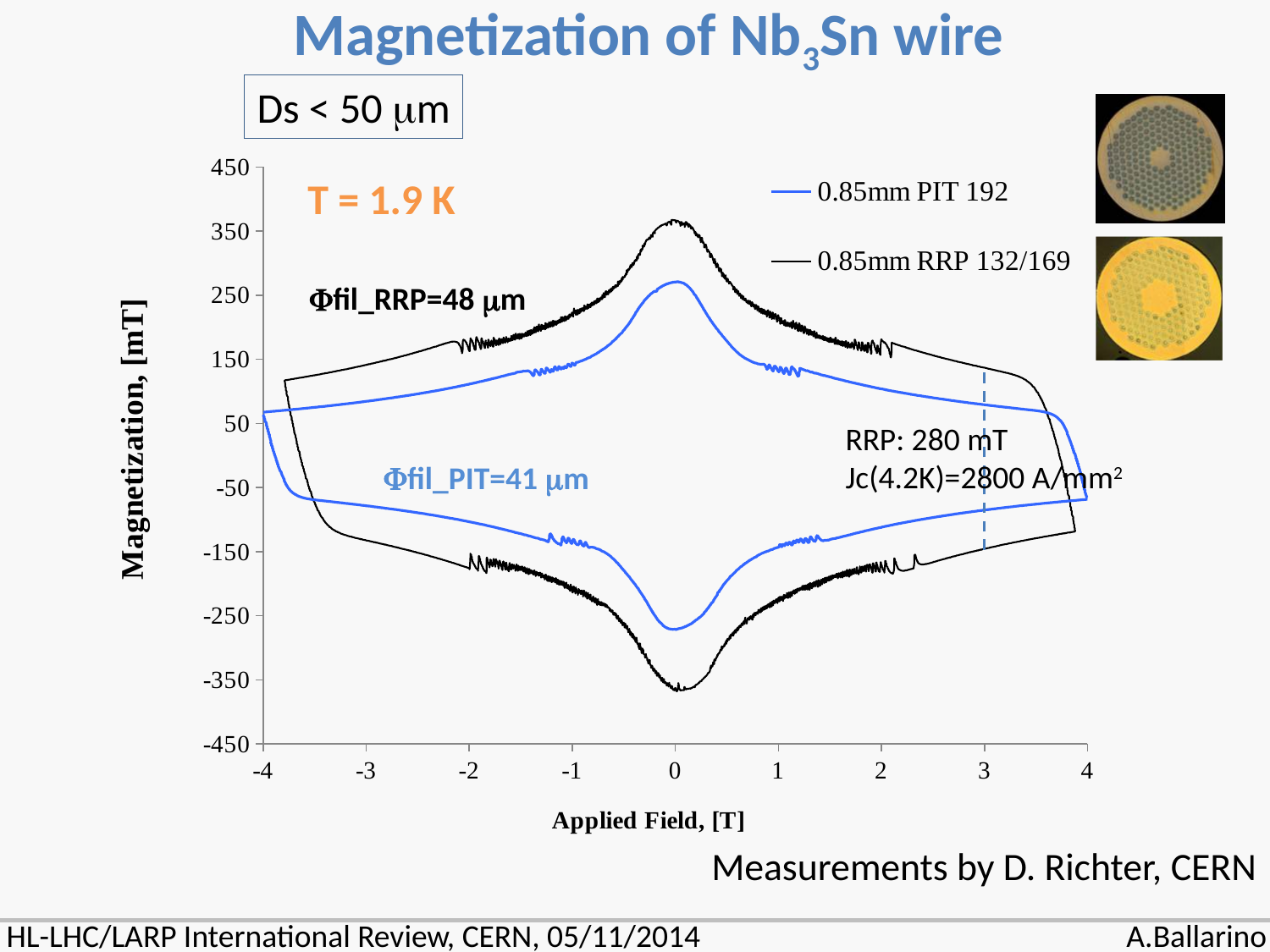
Which series is drawn in blue according to the legend? 0.85mm PIT 192 What magnetization value is annotated for RRP at the dashed line at 3 T? 280 mT Is the peak magnetization of the 0.85mm PIT 192 curve at 0 T greater or less than 350 mT? less What kind of chart is shown on the slide? line chart How many series does the chart legend list? 2 Along the upper branch of the 0.85mm RRP 132/169 curve, does the magnetization rise or fall as the applied field increases from 0 T to 4 T? fall Is the minimum magnetization of the 0.85mm PIT 192 curve near 0 T greater or less than -350 mT? greater What filament diameter is annotated for the RRP wire on the chart? 48 μm What is the label of the x axis of the chart? Applied Field, [T] What filament diameter is annotated for the PIT wire on the chart? 41 μm Is the peak magnetization of the 0.85mm RRP 132/169 curve at 0 T greater or less than 250 mT? greater Which series reaches the higher magnetization at an applied field of 0 T, 0.85mm PIT 192 or 0.85mm RRP 132/169? 0.85mm RRP 132/169